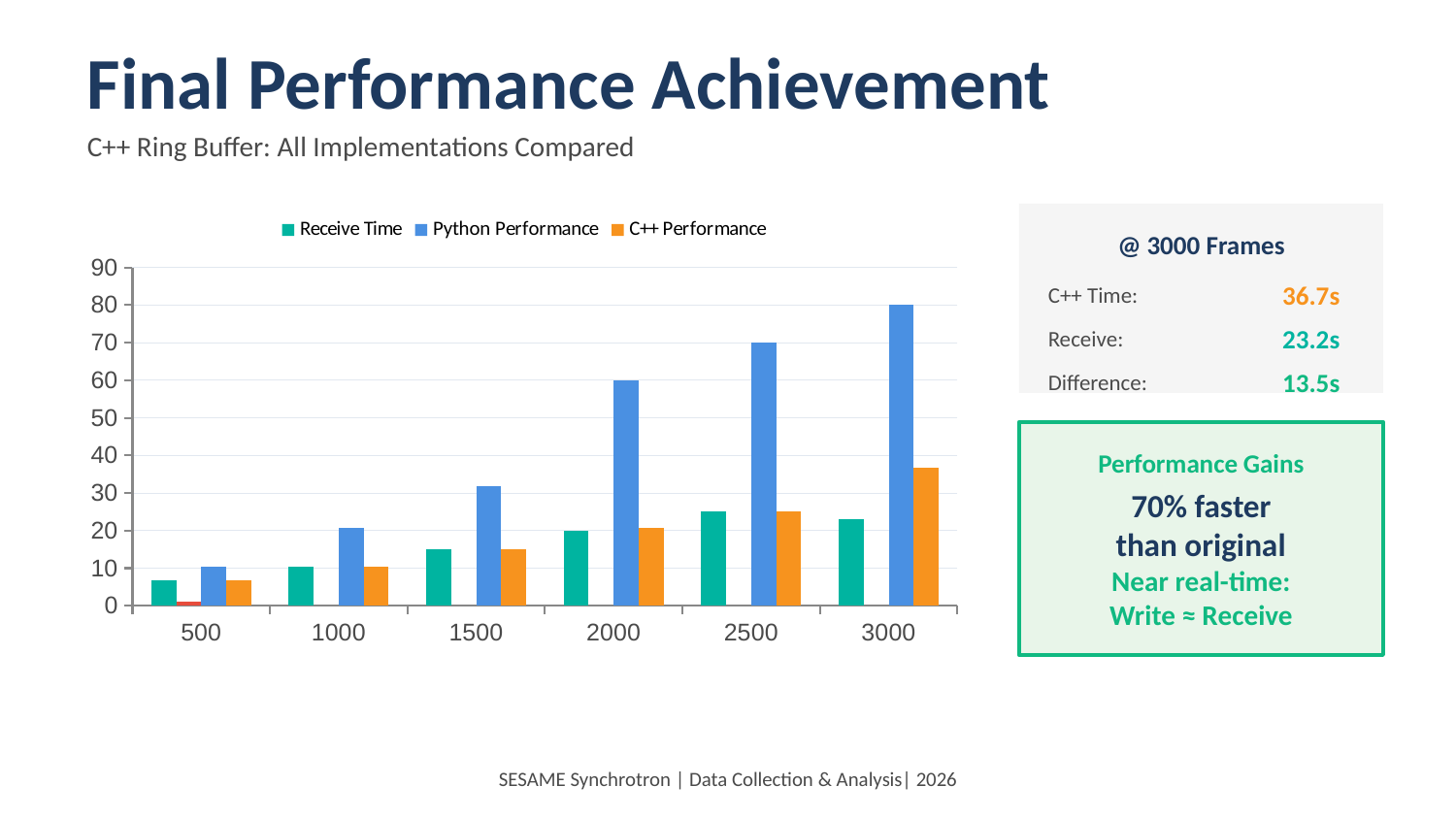
What is the Python Performance value at 2500 frames? 70 What are the three series named in the chart legend? Receive Time, Python Performance, C++ Performance Which frame count has the lowest Python Performance bar? 500 At 2000 frames, which is larger: Python Performance or C++ Performance? Python Performance What is the Python Performance value at 3000 frames? 80 How many frame-count categories are shown on the x axis of the chart? 6 Which frame count has the highest Python Performance bar? 3000 Do the Python Performance values rise or fall as the frame count increases along the x axis? rise How many series does the chart legend list? 3 Is the C++ Performance value at 3000 frames greater or less than 30? greater Is the Receive Time value at 3000 frames greater or less than 30? less What kind of chart is shown on the slide? bar chart